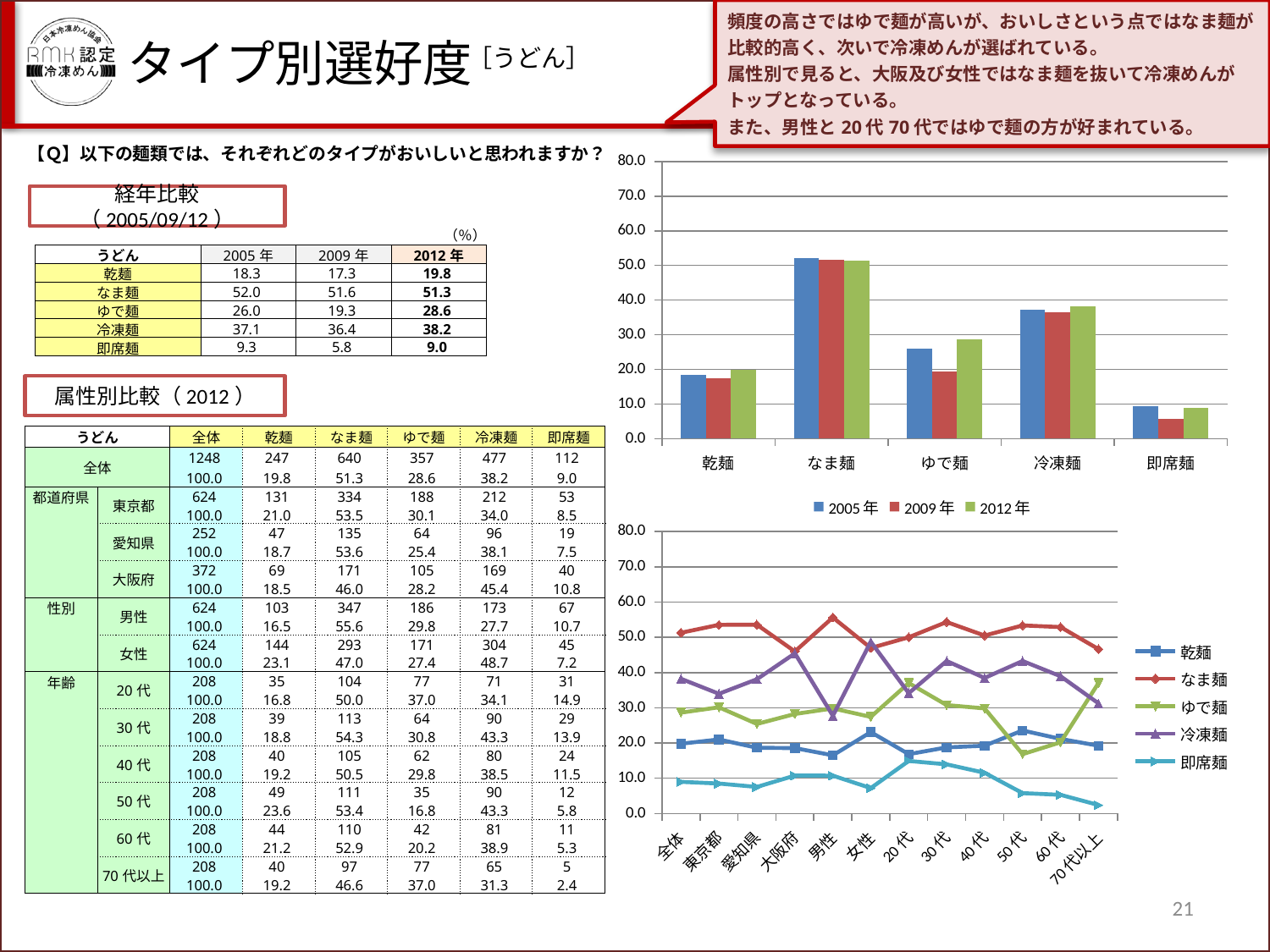
In the bottom line chart, which series has the highest value at 全体? なま麺 What kind of chart is the top chart on the right of the slide? bar chart How many noodle-type categories are shown on the x axis of the top bar chart? 5 In the top bar chart, is the value for なま麺 in 2005年 greater or less than 40.0? greater What kind of chart is the bottom chart on the right of the slide? line chart In the top bar chart, is the value for 即席麺 in 2009年 greater or less than 10.0? less In the top bar chart, which is larger for ゆで麺: the 2009年 value or the 2012年 value? 2012年 How many series does the legend of the bottom line chart list? 5 In the top bar chart, which category has the highest value for 2012年? なま麺 In the top bar chart, which category has the lowest value for 2012年? 即席麺 How many series does the legend of the top bar chart list? 3 How many categories are shown on the x axis of the bottom line chart? 12